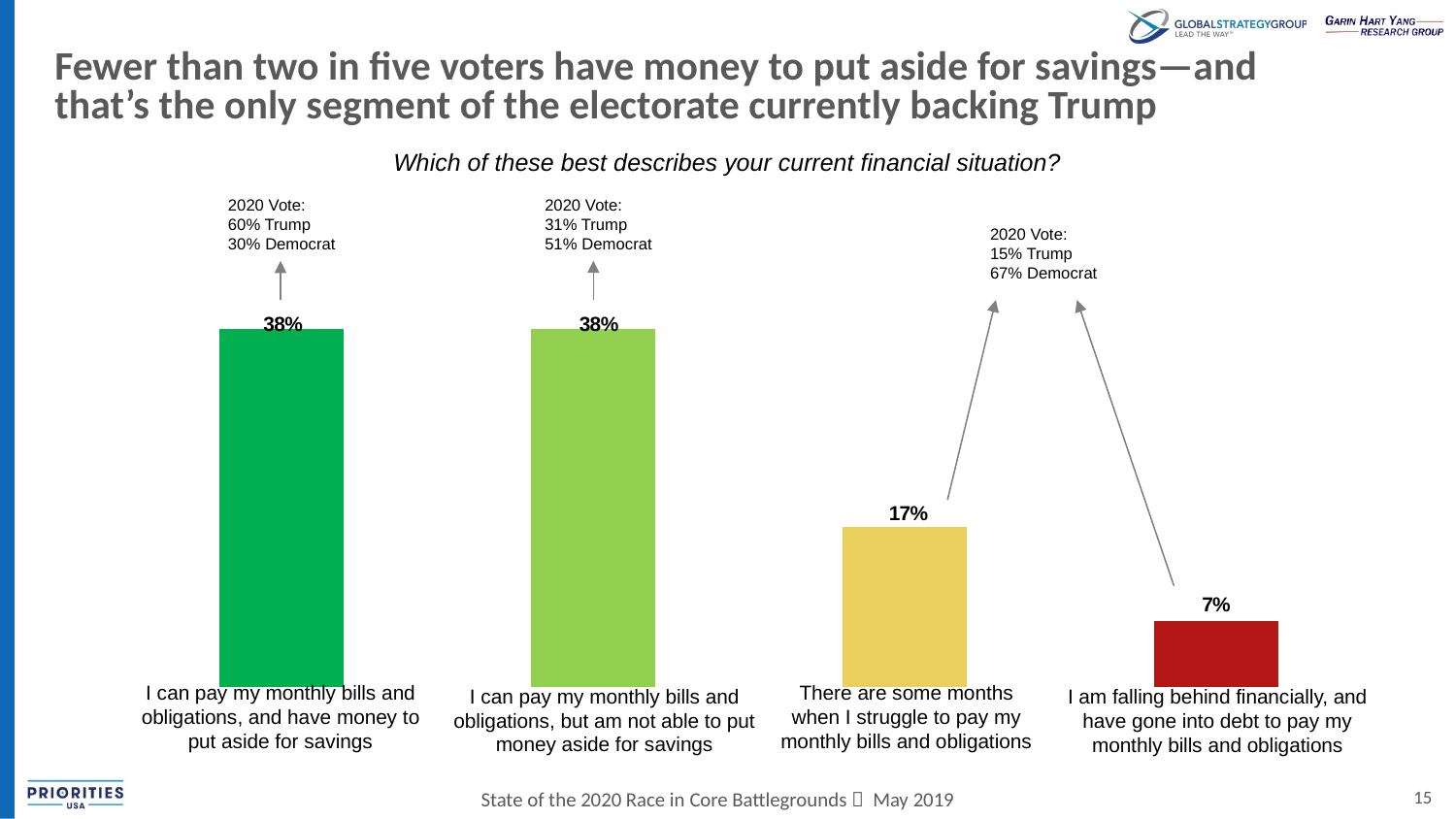
Do the values rise or fall moving from left to right across the chart? Fall What percentage of voters say they are falling behind financially and have gone into debt to pay their monthly bills? 7% What percentage of voters say they can pay their monthly bills and obligations, and have money to put aside for savings? 38% What kind of chart is shown on the slide? Bar chart What is the difference in percentage points between voters who struggle some months to pay bills and voters who are falling behind financially? 10 Which financial situation category has the lowest percentage of voters? I am falling behind financially, and have gone into debt to pay my monthly bills and obligations How many financial situation categories are shown in the chart? 4 What survey question is shown as the chart's title? Which of these best describes your current financial situation? Which is larger: the share of voters who struggle some months to pay bills, or the share who are falling behind financially? There are some months when I struggle to pay my monthly bills and obligations What is the difference in percentage points between voters who can pay bills but cannot save and voters who struggle some months to pay bills? 21 What percentage of voters say there are some months when they struggle to pay their monthly bills and obligations? 17% What is the combined percentage of voters who can pay their monthly bills (with or without savings)? 76%